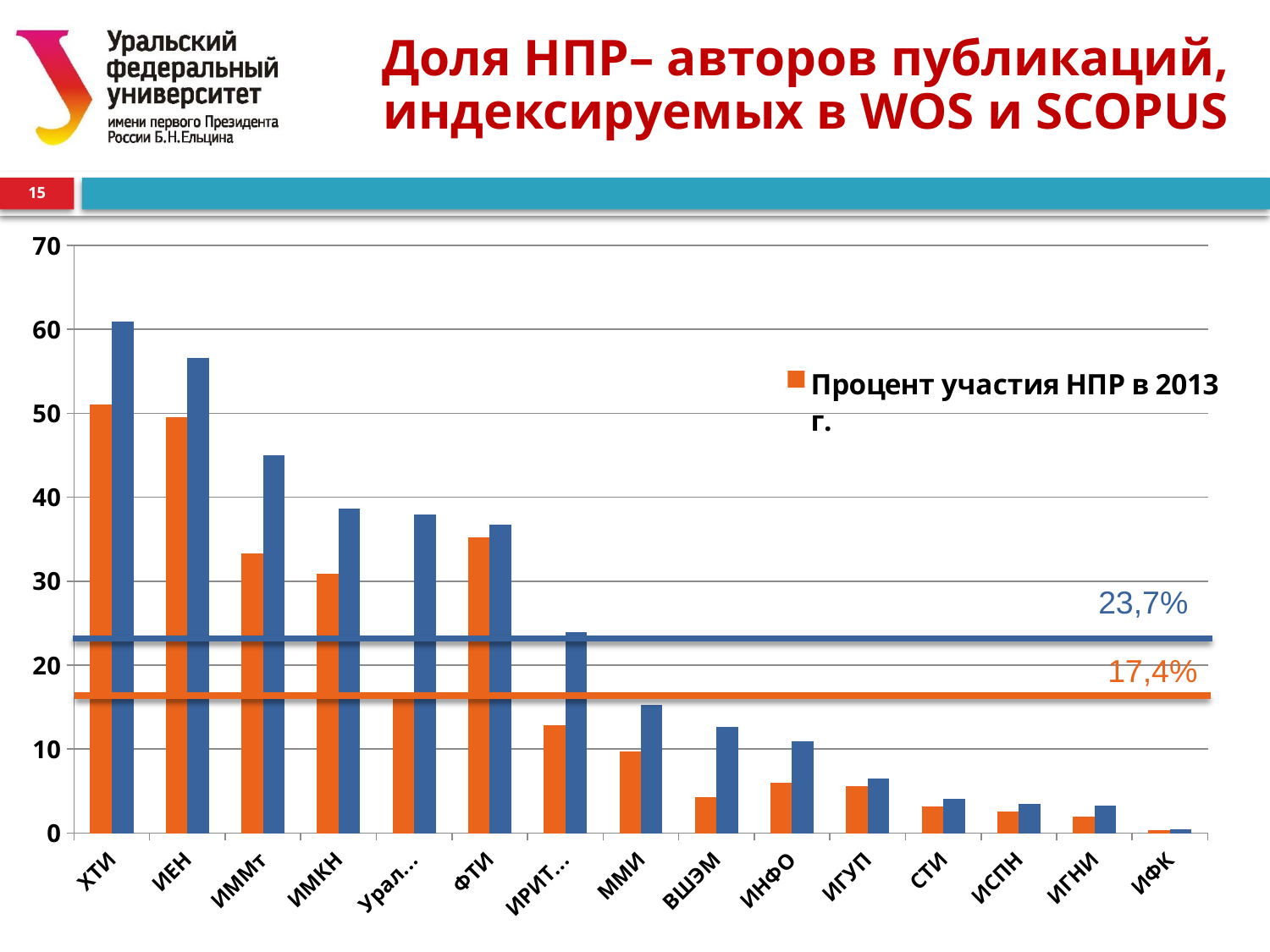
Is the orange bar for ВШЭМ greater or less than 10? less Is the blue bar for ИЕН greater or less than 50? greater Do the bar values generally rise or fall from left to right along the x axis? fall What value is labelled on the blue horizontal line across the chart? 23,7% What kind of chart is shown on the slide? bar chart What value is labelled on the orange horizontal line across the chart? 17,4% Is the blue bar for ИРИТ... greater or less than 20? greater Which category has the highest blue bar? ХТИ What is the legend entry shown for the orange series? Процент участия НПР в 2013 г. Which is larger, the orange bar for ФТИ or the orange bar for ИРИТ...? ФТИ How many categories are shown along the x axis? 15 Which category has the lowest orange bar? ИФК